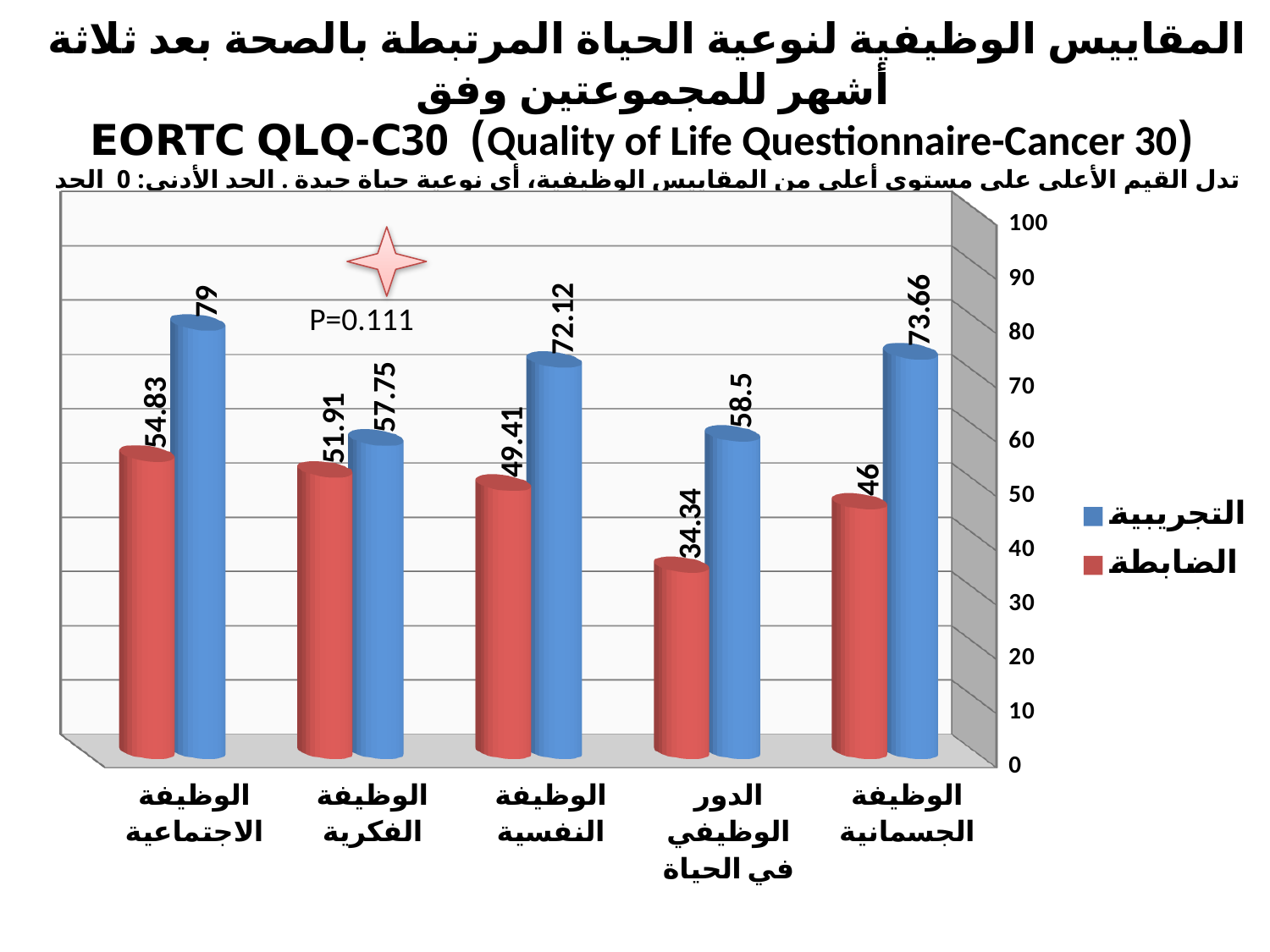
What is the value for الضابطة in الدور الوظيفي في الحياة? 34.34 What P value is annotated on the chart? P=0.111 What kind of chart is shown on the slide? Bar chart Which category has the highest value for التجريبية? الوظيفة الاجتماعية What is the difference between التجريبية and الضابطة in الوظيفة النفسية? 22.71 What is the value for الضابطة in الوظيفة الفكرية? 51.91 How many series does the legend list? 2 What is the value for التجريبية in الوظيفة الجسمانية? 73.66 What is the value for التجريبية in الوظيفة الاجتماعية? 79 Which category has the lowest value for الضابطة? الدور الوظيفي في الحياة Which is larger in الوظيفة الفكرية: التجريبية or الضابطة? التجريبية How many categories are shown on the x axis? 5